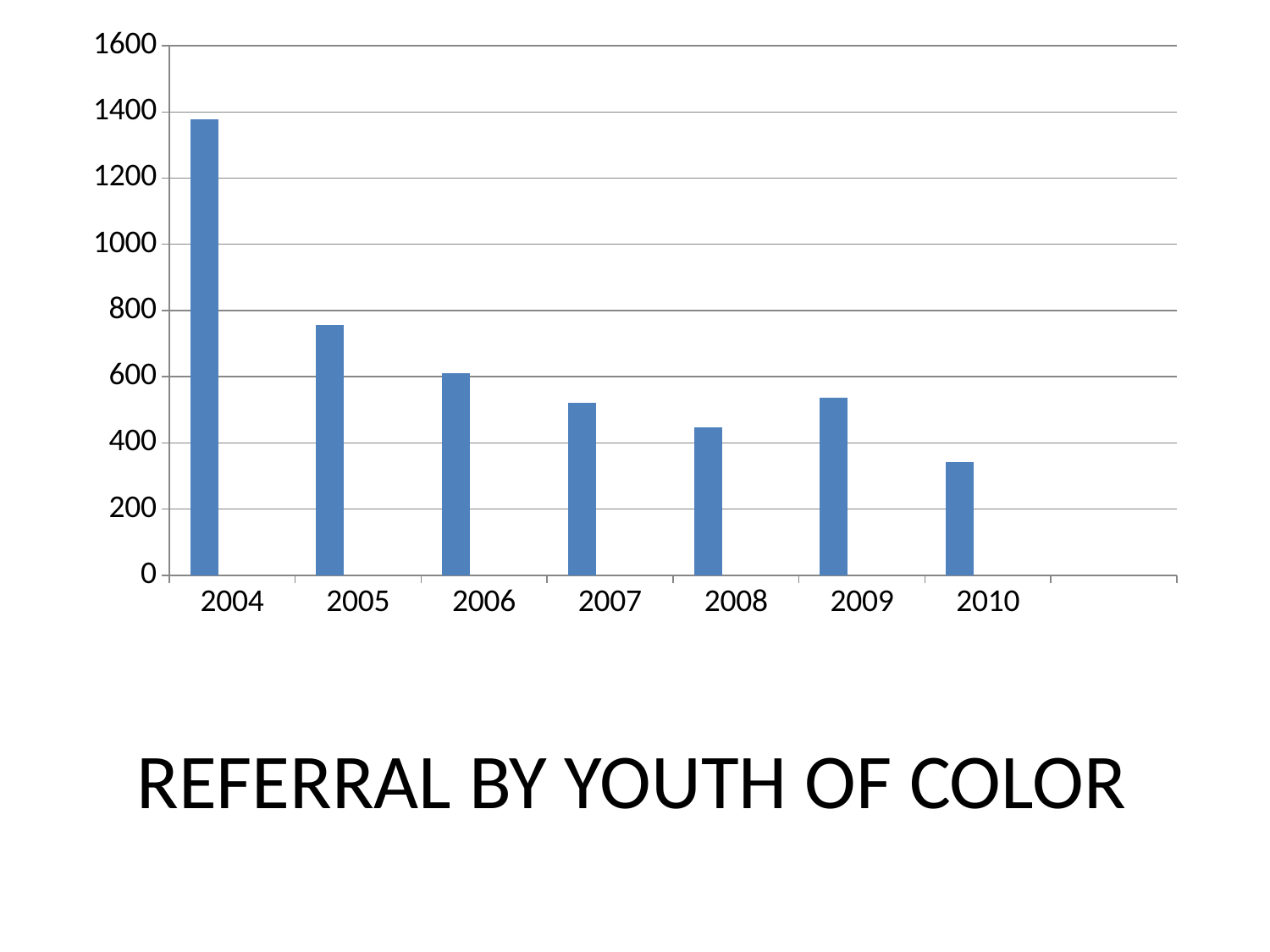
What kind of chart is shown on the slide? Bar chart Is the value for 2005 greater or less than 800? less What is the title shown below the chart? REFERRAL BY YOUTH OF COLOR Do the values generally rise or fall from 2004 to 2010? fall Is the value for 2004 greater or less than 1200? greater Is the value for 2008 greater or less than 400? greater Which year has the highest value in the chart? 2004 How many years are plotted on the x axis of the chart? 7 Which year has the lowest value in the chart? 2010 Which is larger, the value for 2008 or the value for 2009? 2009 Which is larger, the value for 2005 or the value for 2006? 2005